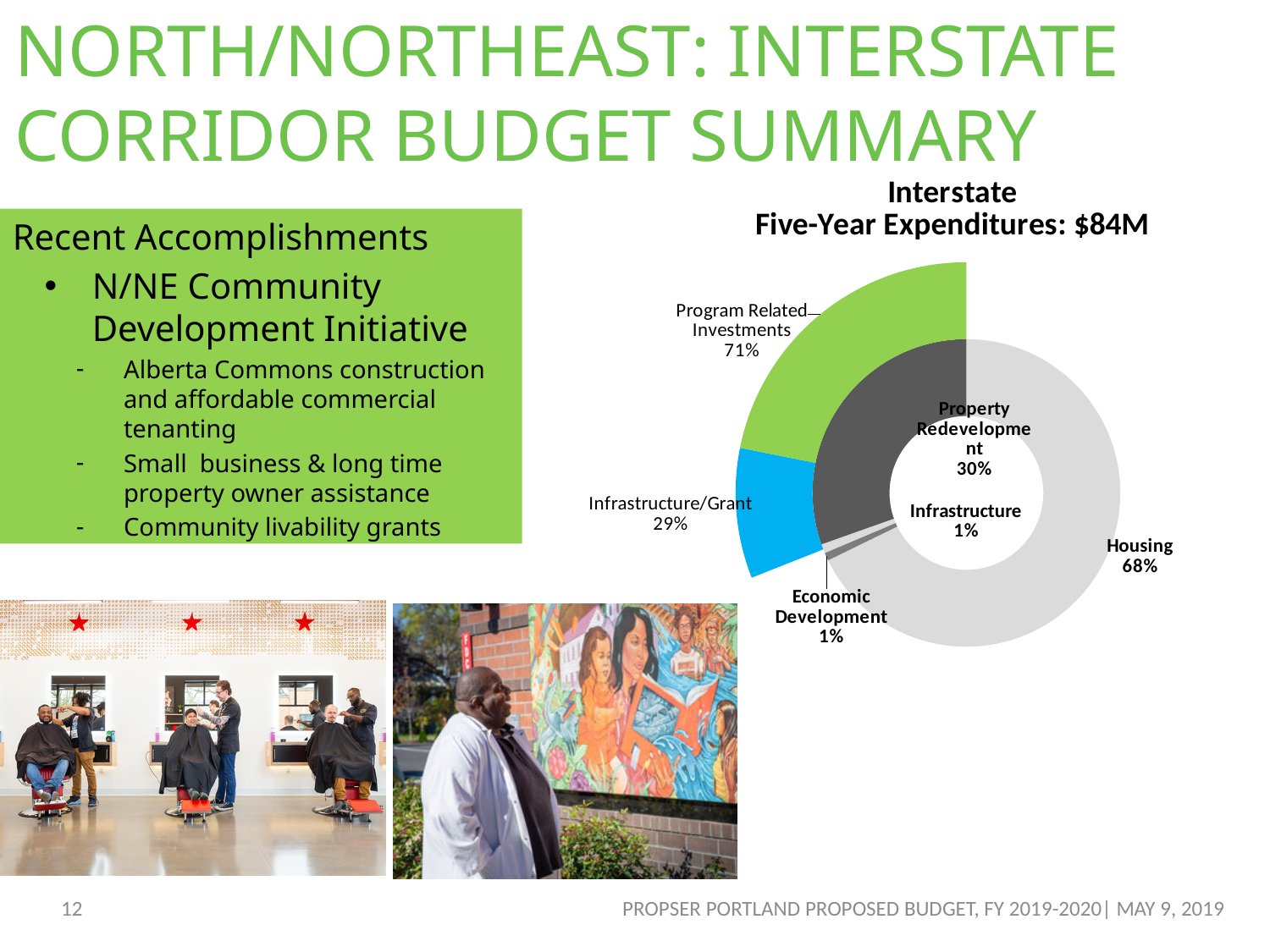
What share of the inner ring of the chart is Property Redevelopment? 30% What is the title of the chart on the slide? Interstate Five-Year Expenditures: $84M Which is larger in the inner ring, Property Redevelopment or Infrastructure? Property Redevelopment What share of the inner ring of the chart is Housing? 68% What share of the outer ring of the chart is Infrastructure/Grant? 29% What share of the outer ring of the chart is Program Related Investments? 71% What is the difference in percentage points between Program Related Investments and Infrastructure/Grant in the outer ring? 42 Which category has the largest share in the inner ring of the chart? Housing How many categories are labelled in the inner ring of the chart? 4 What kind of chart is shown on the slide? doughnut chart What is the difference in percentage points between Housing and Property Redevelopment in the inner ring? 38